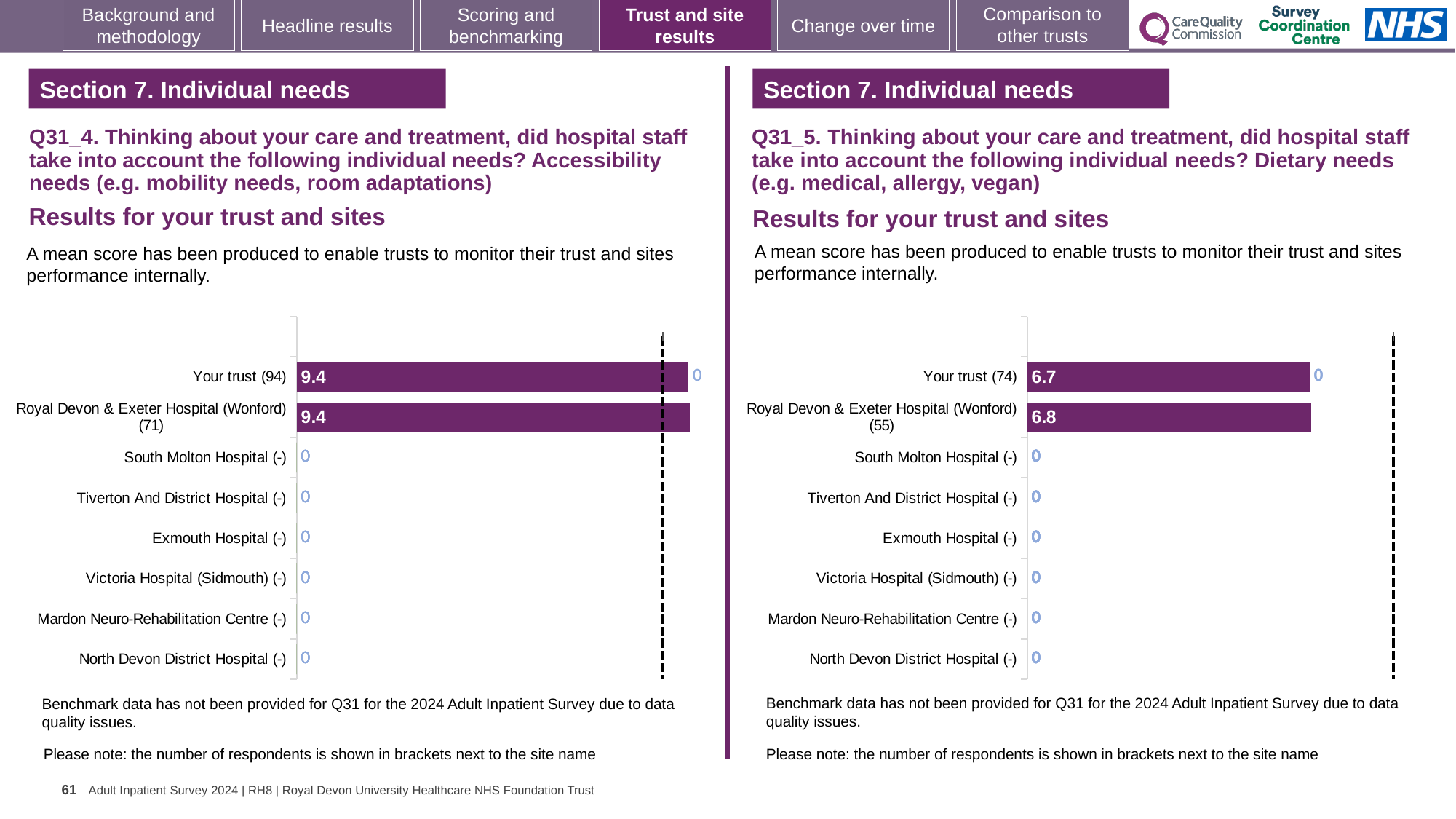
On the right chart (Q31_5, Dietary needs), which has the higher score: Your trust or Royal Devon & Exeter Hospital (Wonford)? Royal Devon & Exeter Hospital (Wonford) On the right chart (Q31_5, Dietary needs), what is the mean score for Your trust (74)? 6.7 On the left chart (Q31_4), what value is shown for South Molton Hospital (-)? 0 How many categories (sites including Your trust) are listed on the left chart (Q31_4)? 8 On the left chart (Q31_4, Accessibility needs), what is the mean score for Your trust (94)? 9.4 On the left chart (Q31_4, Accessibility needs), what is the mean score for Royal Devon & Exeter Hospital (Wonford) (71)? 9.4 On the right chart (Q31_5, Dietary needs), what is the difference between the scores for Royal Devon & Exeter Hospital (Wonford) and Your trust? 0.1 What type of chart is used on the right (Q31_5, Dietary needs)? Bar chart What is the difference between the Your trust score on the left chart (Q31_4) and the Your trust score on the right chart (Q31_5)? 2.7 On the left chart (Q31_4), how many respondents are shown in brackets for Royal Devon & Exeter Hospital (Wonford)? 71 On the right chart (Q31_5, Dietary needs), what is the mean score for Royal Devon & Exeter Hospital (Wonford) (55)? 6.8 On the right chart (Q31_5), how many respondents are shown in brackets for Your trust? 74